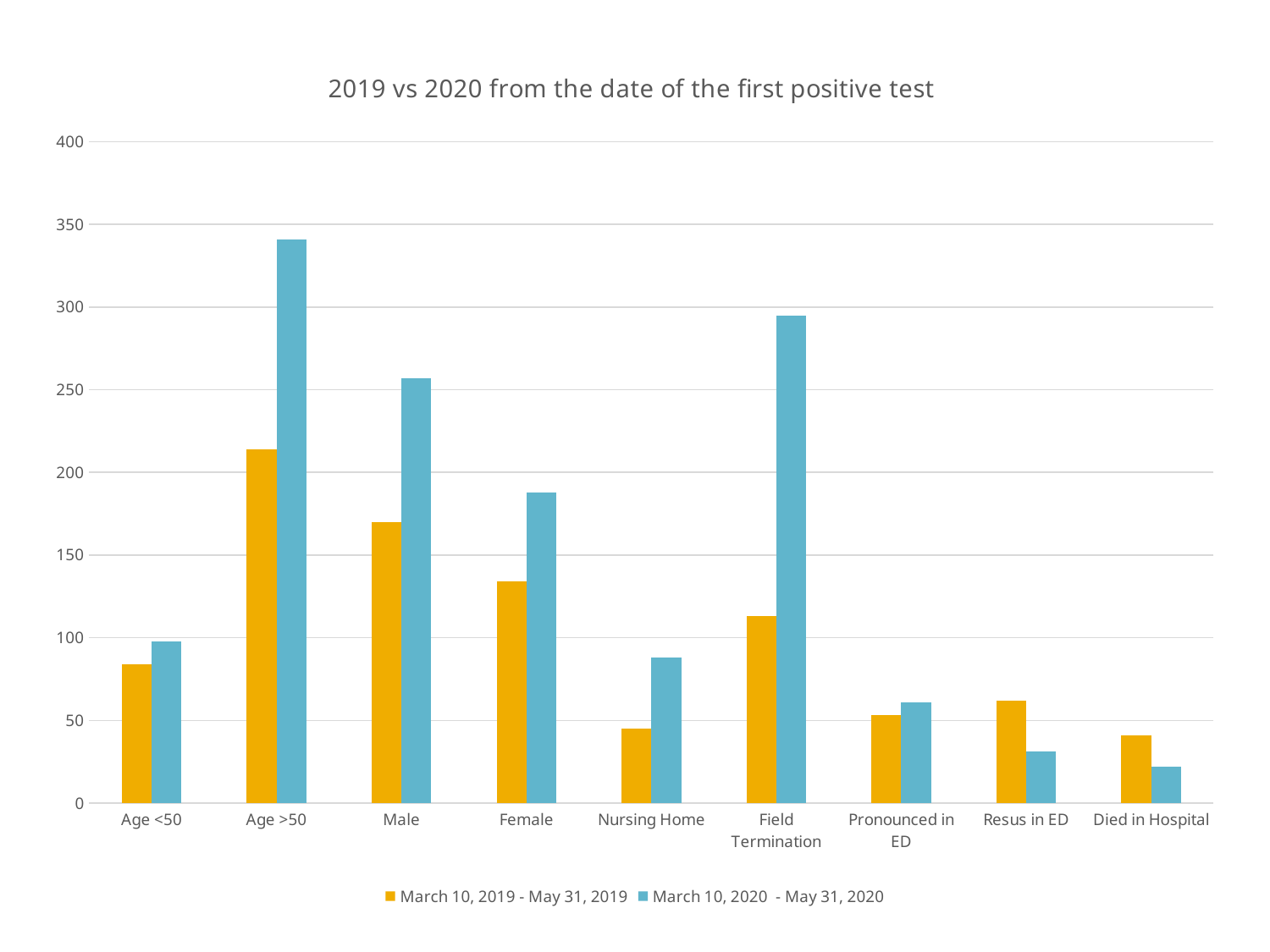
What kind of chart is shown on the slide? bar chart How many categories are shown on the x axis? 9 Which category has the highest value for the March 10, 2020 - May 31, 2020 series? Age >50 Is the value for Field Termination in the March 10, 2020 - May 31, 2020 series greater or less than 250? greater Which category has the lowest value for the March 10, 2020 - May 31, 2020 series? Died in Hospital Is the value for Age >50 in the March 10, 2020 - May 31, 2020 series greater or less than 300? greater What is the title of the chart? 2019 vs 2020 from the date of the first positive test How many series does the legend list? 2 Which category has the highest value for the March 10, 2019 - May 31, 2019 series? Age >50 For Resus in ED, which series has the larger value: March 10, 2019 - May 31, 2019 or March 10, 2020 - May 31, 2020? March 10, 2019 - May 31, 2019 Is the value for Nursing Home in the March 10, 2019 - May 31, 2019 series greater or less than 50? less In the March 10, 2020 - May 31, 2020 series, which is larger: Age >50 or Field Termination? Age >50